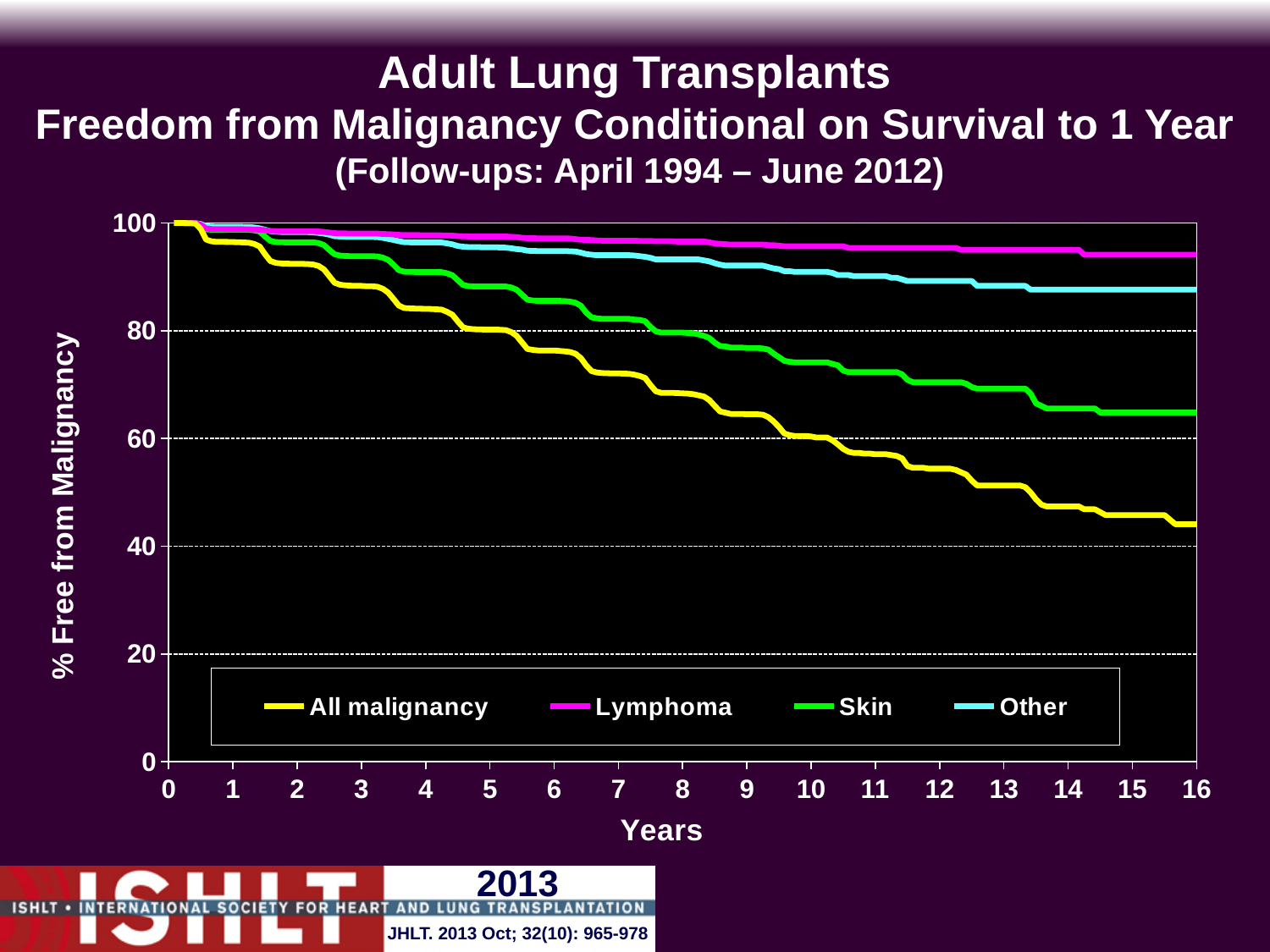
What kind of chart is shown on the slide? Line chart What colour is the Skin series line? Green Which series has the lowest % free from malignancy at 16 years? All malignancy At 16 years, which is higher: Lymphoma or Skin? Lymphoma Is the value for Lymphoma at 16 years greater or less than 80? greater What is the label of the y axis? % Free from Malignancy Is the value for Skin at 16 years greater or less than 60? greater Is the value for All malignancy at 8 years greater or less than 80? less How many series does the legend list? 4 Which series has the highest % free from malignancy at 16 years? Lymphoma Do the curves rise or fall as years increase? Fall